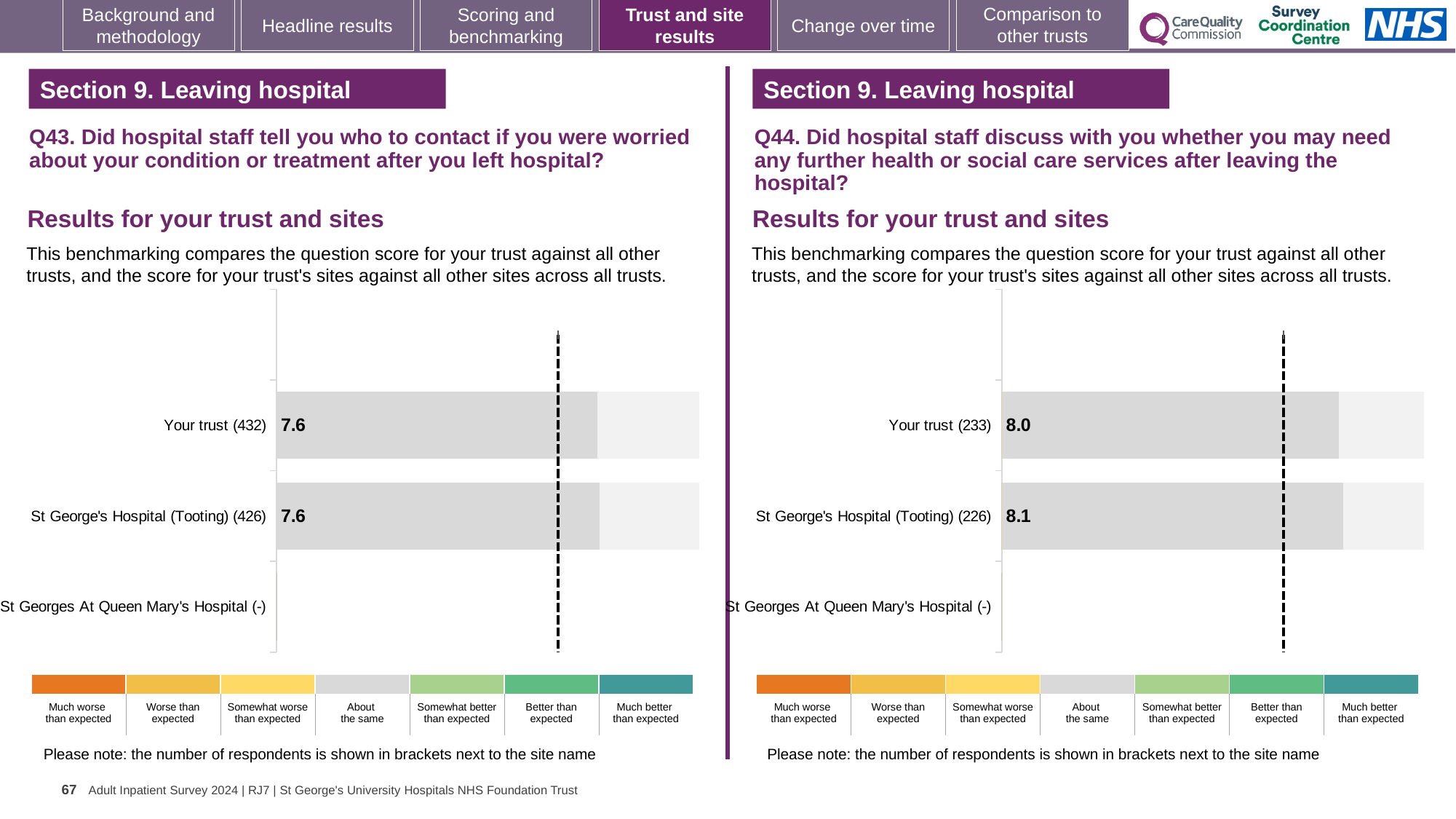
On the Q44 chart (right), which category has a higher score: Your trust or St George's Hospital (Tooting)? St George's Hospital (Tooting) What kind of chart is used on the Q44 chart (right)? Bar chart On the Q43 chart (left), how many respondents are shown in brackets for Your trust? 432 On the Q43 chart (left), how many categories are shown in the colour key below the chart? 7 On the Q43 chart (left), what is the score for Your trust? 7.6 On the Q44 chart (right), what is the score for Your trust? 8.0 On the Q43 chart (left), how many site/trust categories are listed on the vertical axis? 3 On the Q44 chart (right), how many respondents are shown in brackets for St George's Hospital (Tooting)? 226 On the Q43 chart (left), what is the score for St George's Hospital (Tooting)? 7.6 On the Q43 chart (left), is the score for Your trust the same as the score for St George's Hospital (Tooting)? Yes On the Q44 chart (right), what is the difference between the score for St George's Hospital (Tooting) and the score for Your trust? 0.1 On the Q44 chart (right), what is the score for St George's Hospital (Tooting)? 8.1